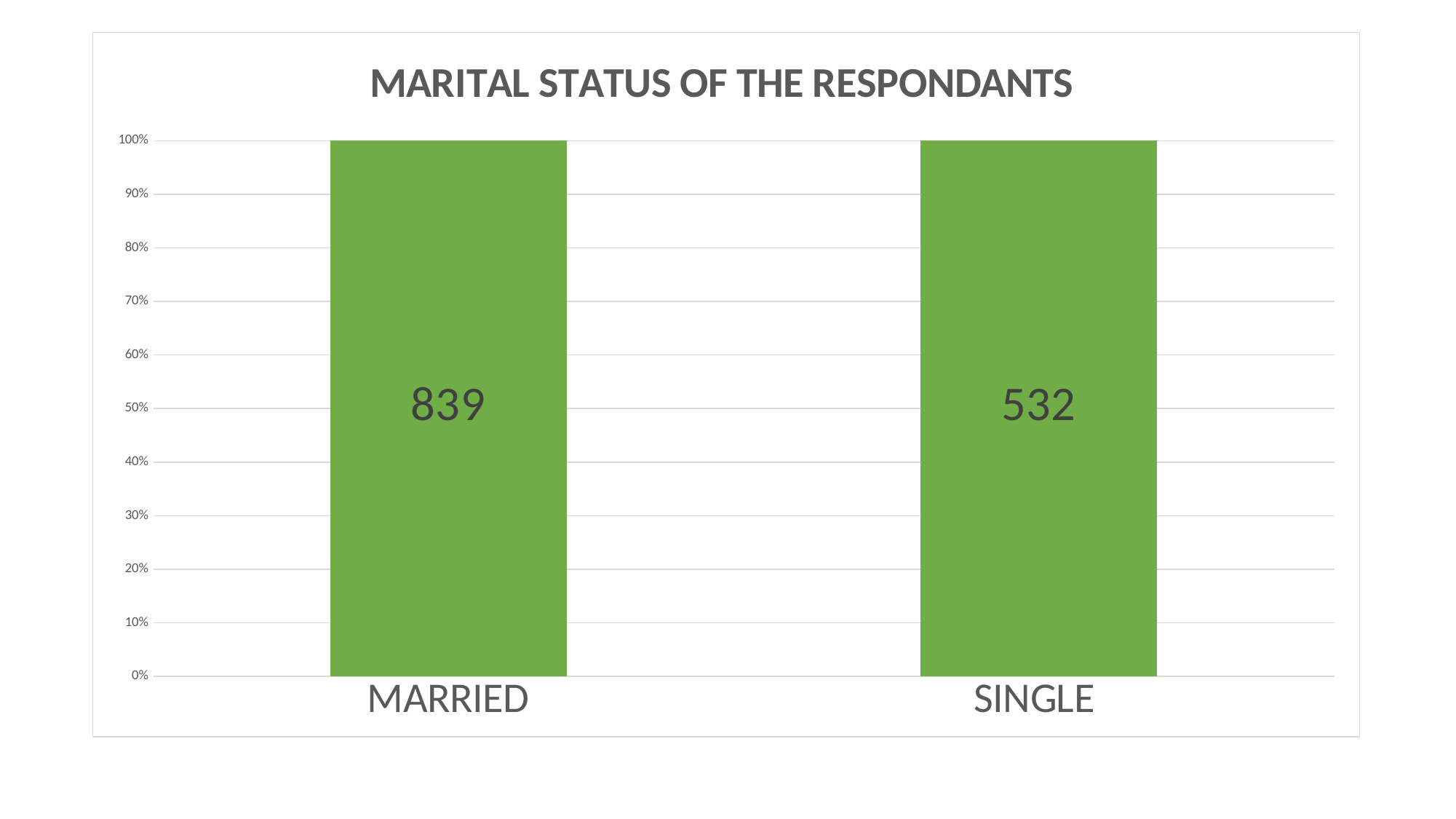
What colour are the bars in the chart? Green How many categories are shown on the x axis? 2 What percentage level does the top of the SINGLE bar reach on the y axis? 100% What is the title of the chart? MARITAL STATUS OF THE RESPONDANTS Which category has the higher labelled value, MARRIED or SINGLE? MARRIED What is the data label shown on the MARRIED bar? 839 What is the highest value shown on the y axis? 100% Which category has the lowest labelled value? SINGLE What is the data label shown on the SINGLE bar? 532 What is the difference between the labelled values for MARRIED and SINGLE? 307 What kind of chart is shown on the slide? Bar chart Which category has the highest labelled value? MARRIED